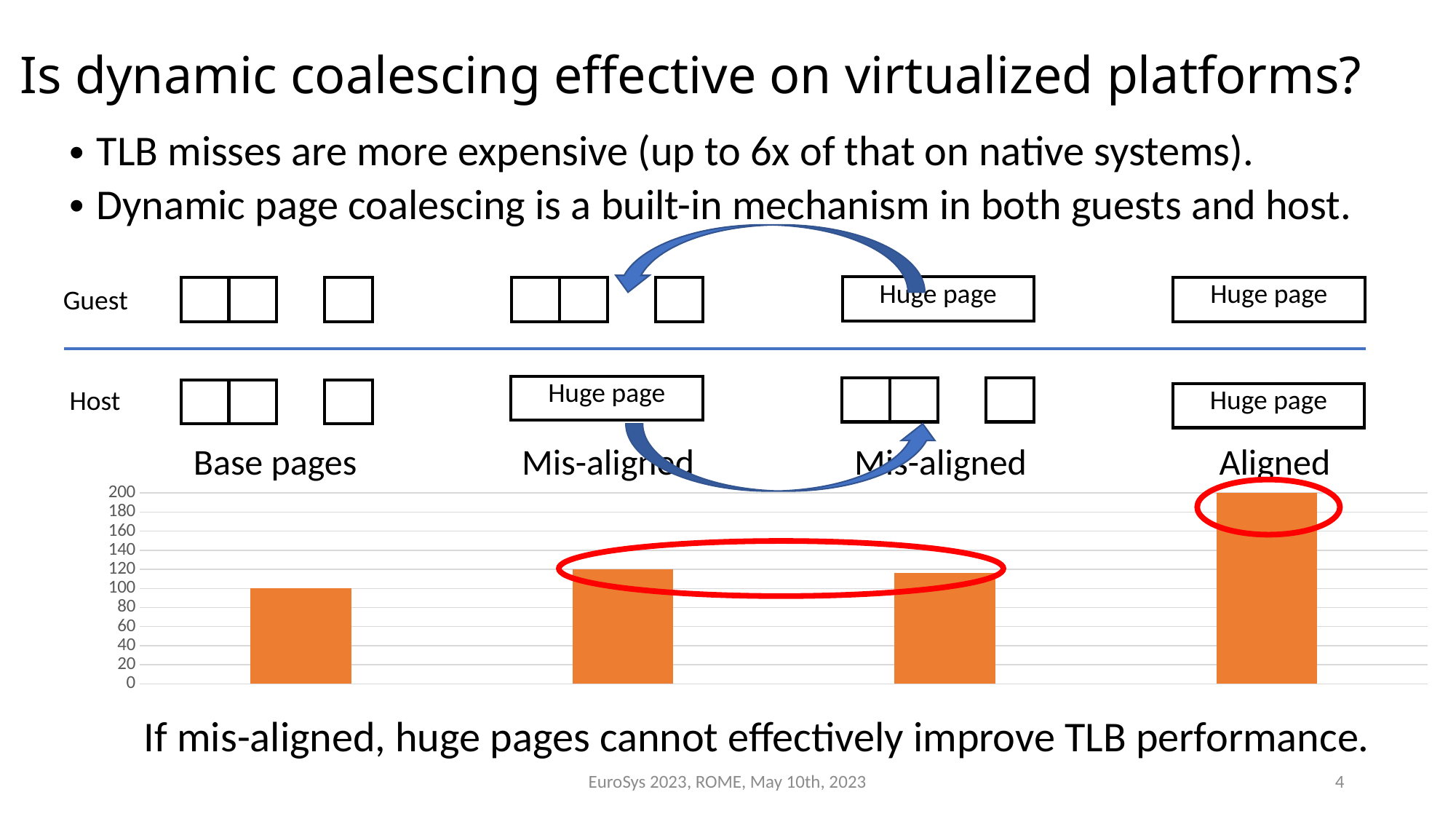
Which is larger, the Aligned bar or the Base pages bar? Aligned Which category has the lowest bar in the chart? Base pages What is the value of the Base pages bar? 100 What colour are the bars in the chart? orange What kind of chart is shown on the slide? bar chart Which category has the highest bar in the chart? Aligned How many bars does the chart show? 4 Is the value of the second Mis-aligned bar (the one to the right) greater or less than 100? greater Is the value of the Aligned bar greater or less than 180? greater What is the value of the first Mis-aligned bar (the one to the left)? 120